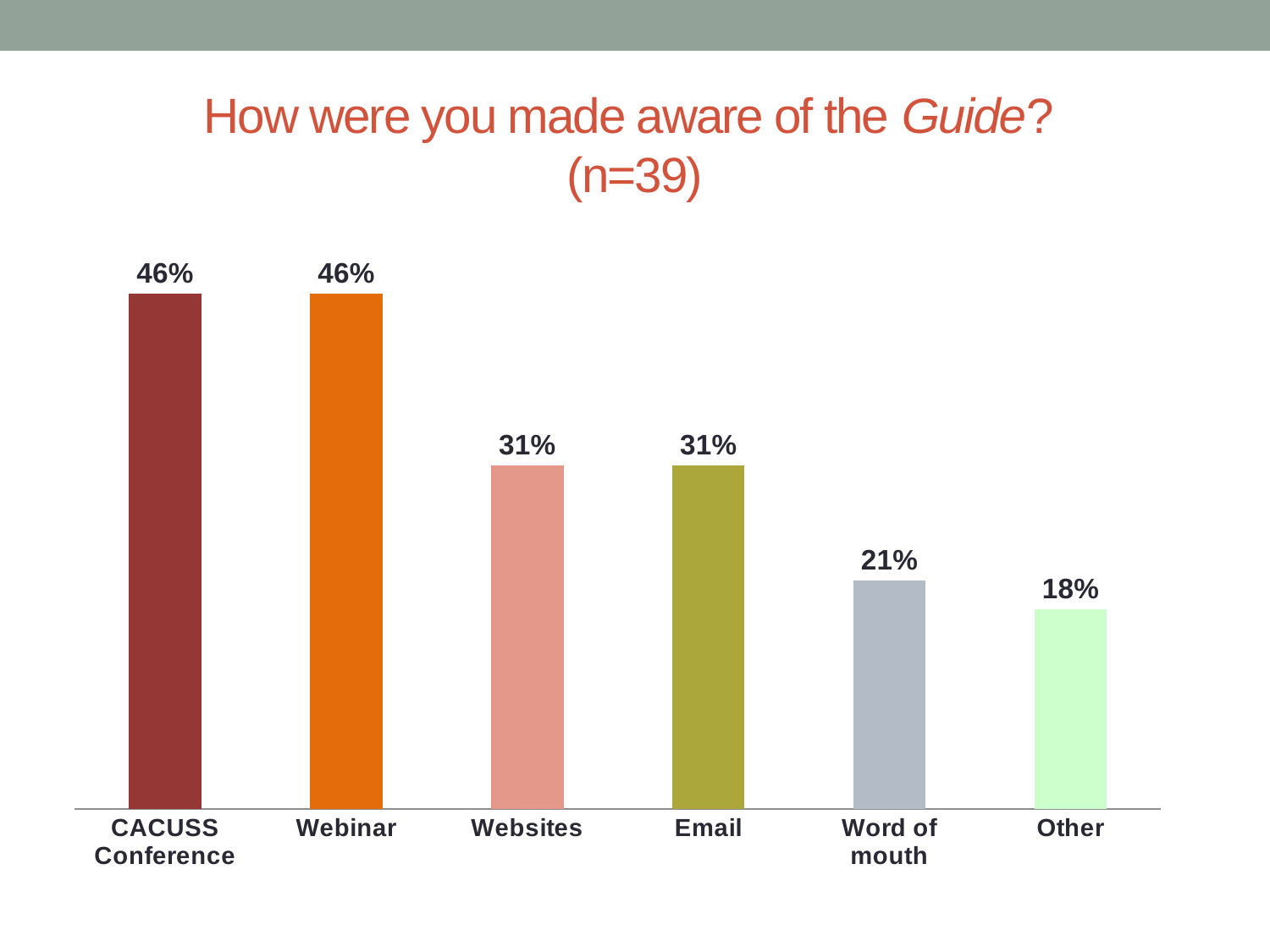
Do the values rise or fall from left to right along the x axis? Fall What is the value shown for Websites? 31% Which category has the lowest value? Other What is the difference between the values for Email and Word of mouth? 10% Which is larger, the value for Websites or the value for Word of mouth? Websites How many categories are shown on the x axis? 6 What is the value shown for Other? 18% What is the difference between the values for CACUSS Conference and Other? 28% What is the sample size (n) given in the chart title? 39 What kind of chart is shown on the slide? Bar chart What is the value shown for Word of mouth? 21% What percentage of respondents were made aware of the Guide through a Webinar? 46%